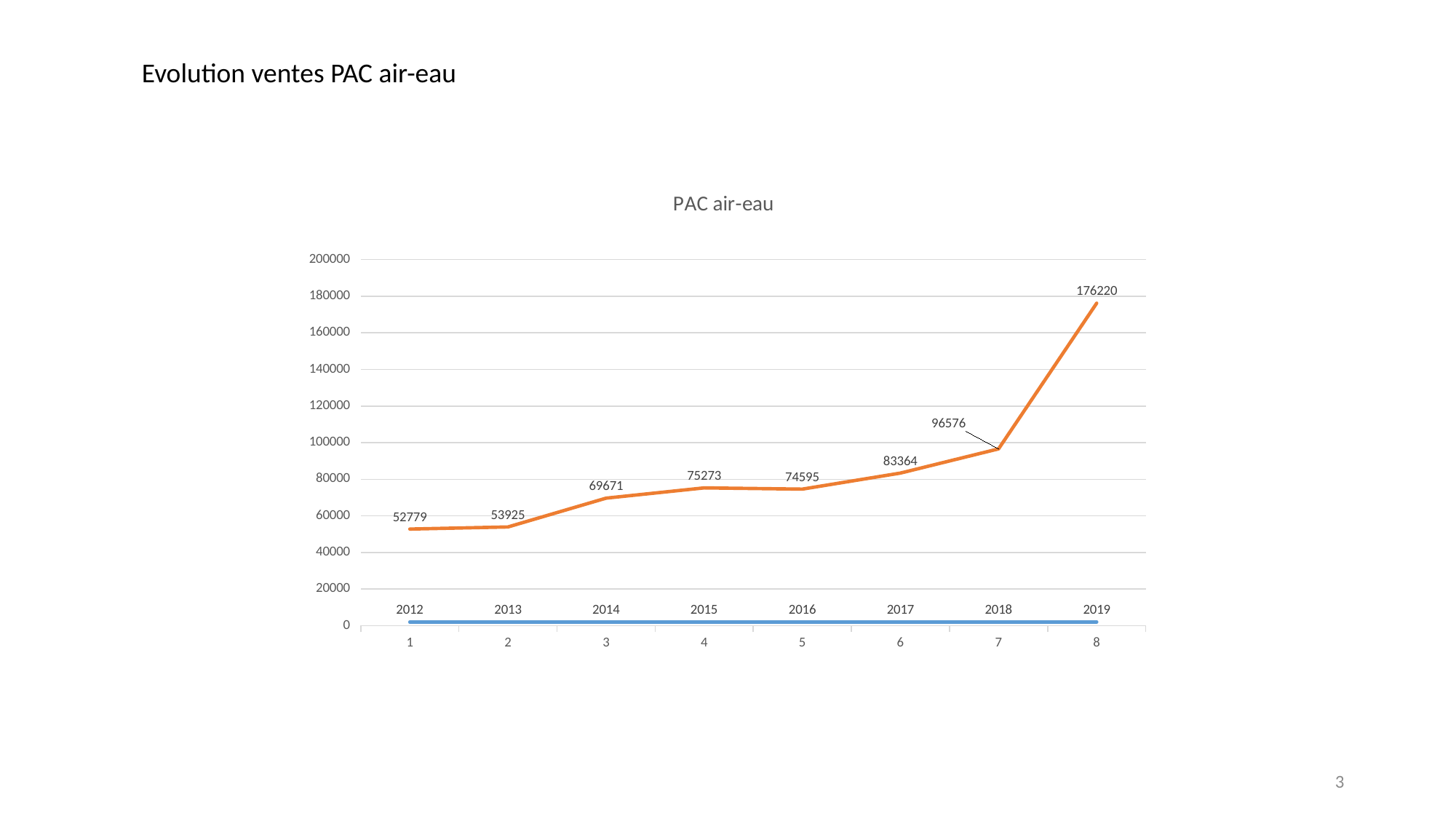
What is the value of the orange line at x-axis position 1 (labelled 2012)? 52779 How many data points does the orange line have? 8 What type of chart is shown on the slide? line chart At which x-axis position does the orange line have its lowest value? 1 (2012) What is the value of the orange line at x-axis position 8 (labelled 2019)? 176220 Which is larger on the orange line: the value at position 4 (2015) or at position 5 (2016)? 2015 (75273) What is the value of the orange line at x-axis position 4 (labelled 2015)? 75273 At which x-axis position does the orange line reach its highest value? 8 (2019) What is the difference between the orange line's values at position 8 (2019) and position 7 (2018)? 79644 What is the value of the orange line at x-axis position 7 (labelled 2018)? 96576 What is the title of the chart? PAC air-eau Does the orange line generally rise or fall from left to right along the x axis? rise